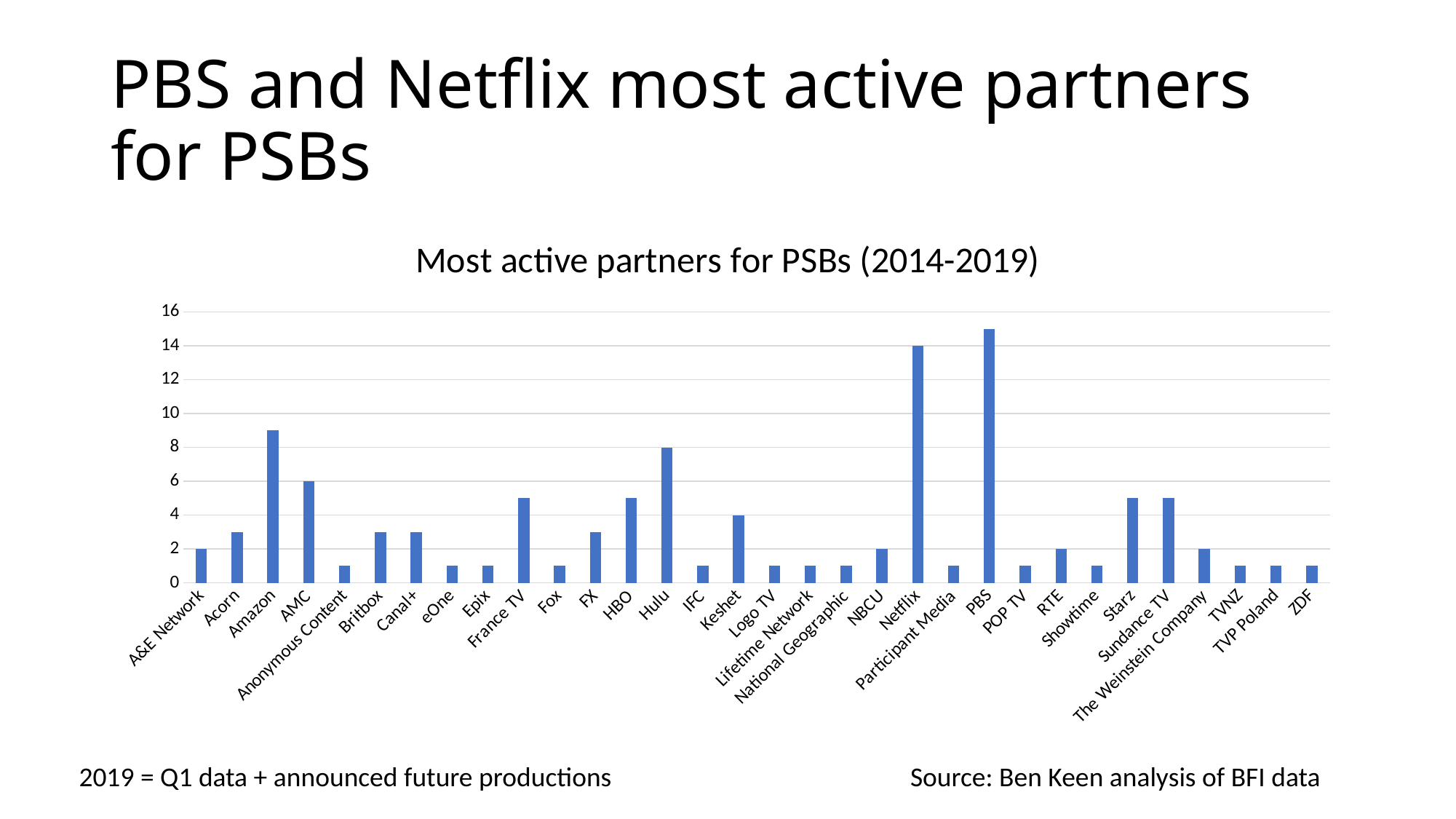
Is the value for Amazon greater or less than 8? greater Which has a larger value, AMC or Keshet? AMC What is the value for Netflix? 14 What kind of chart is shown on the slide? bar chart Which partner has the highest bar in the chart? PBS What is the title of the chart? Most active partners for PSBs (2014-2019) What is the difference between the values for Netflix and Hulu? 6 What is the value for Hulu? 8 What is the value for Keshet? 4 Is the value for PBS greater or less than 14? greater How many partners are shown on the x axis of the chart? 32 What is the value for AMC? 6